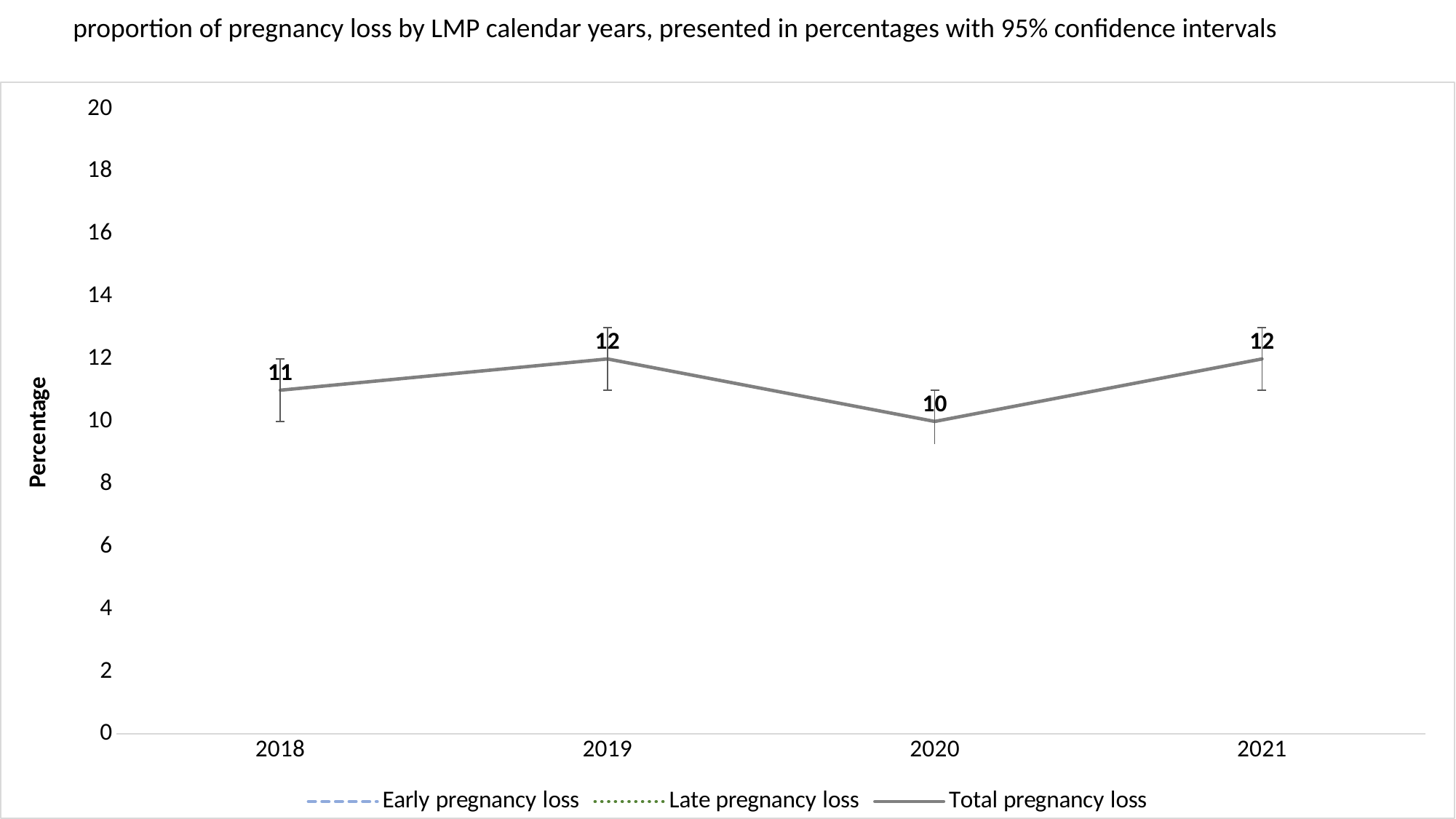
What is the total pregnancy loss percentage for 2018? 11 Which year has the lowest total pregnancy loss percentage? 2020 What kind of chart is shown on the slide? line chart Does the total pregnancy loss percentage rise or fall from 2019 to 2020? fall What is the total pregnancy loss percentage for 2020? 10 What is the total pregnancy loss percentage for 2021? 12 How many years are shown on the x axis? 4 How many series does the legend list? 3 Is the total pregnancy loss percentage higher in 2018 or in 2020? 2018 What is the label on the vertical axis? Percentage What is the difference between the total pregnancy loss percentage in 2019 and in 2020? 2 Is the total pregnancy loss value for 2019 greater or less than 14? less